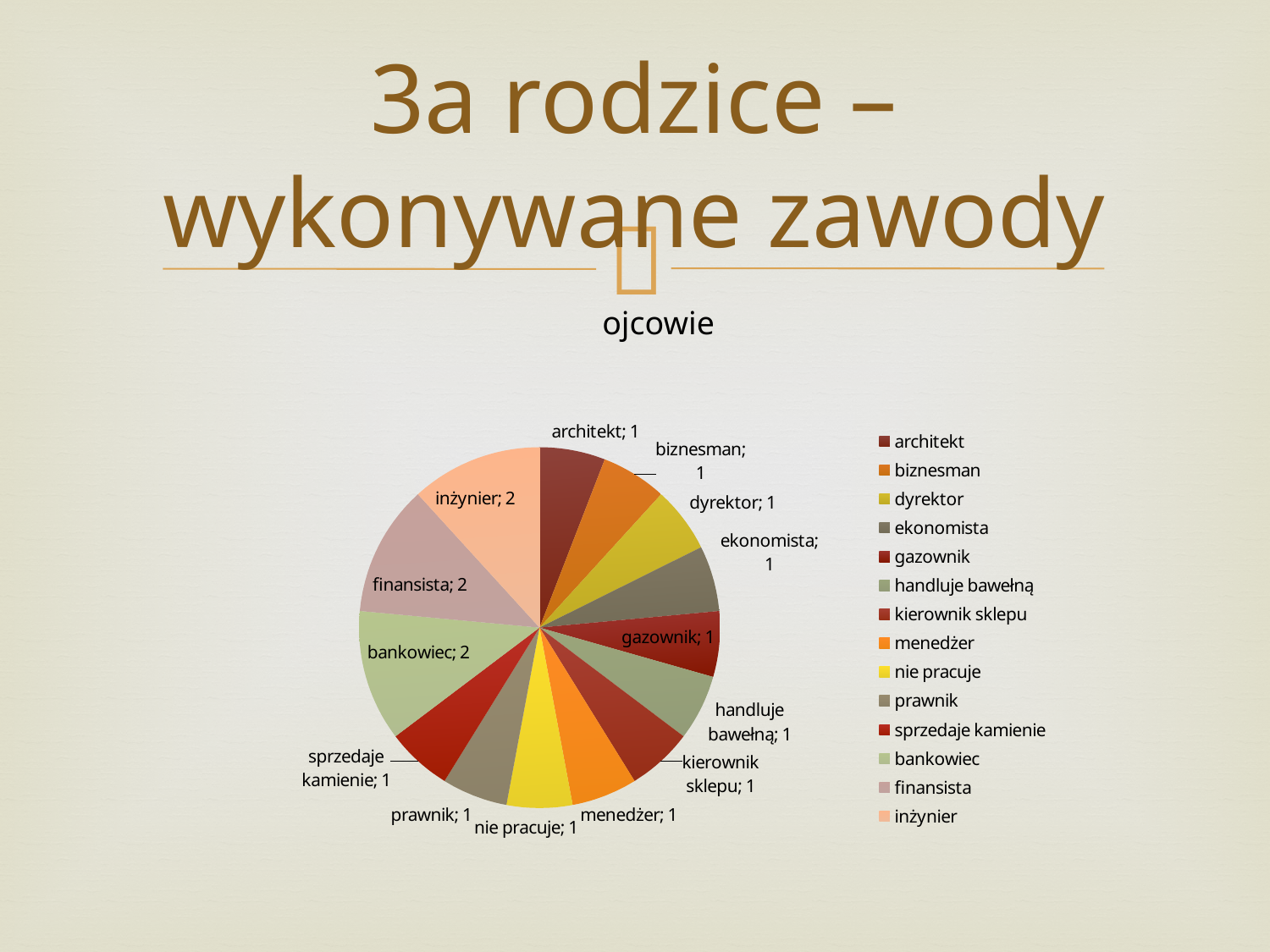
What is the value for nie pracuje? 1 How many categories does the pie chart have? 14 What is the title of the chart? ojcowie What is the value for gazownik? 1 Which legend entry is listed last? inżynier Which categories have the highest value in the pie chart? bankowiec, finansista, inżynier What is the value for bankowiec? 2 What is the total of all the values in the pie chart? 17 What is the difference between the value for inżynier and the value for architekt? 1 What is the value for inżynier? 2 What type of chart is shown on the slide? pie chart Which is larger, the value for finansista or the value for prawnik? finansista